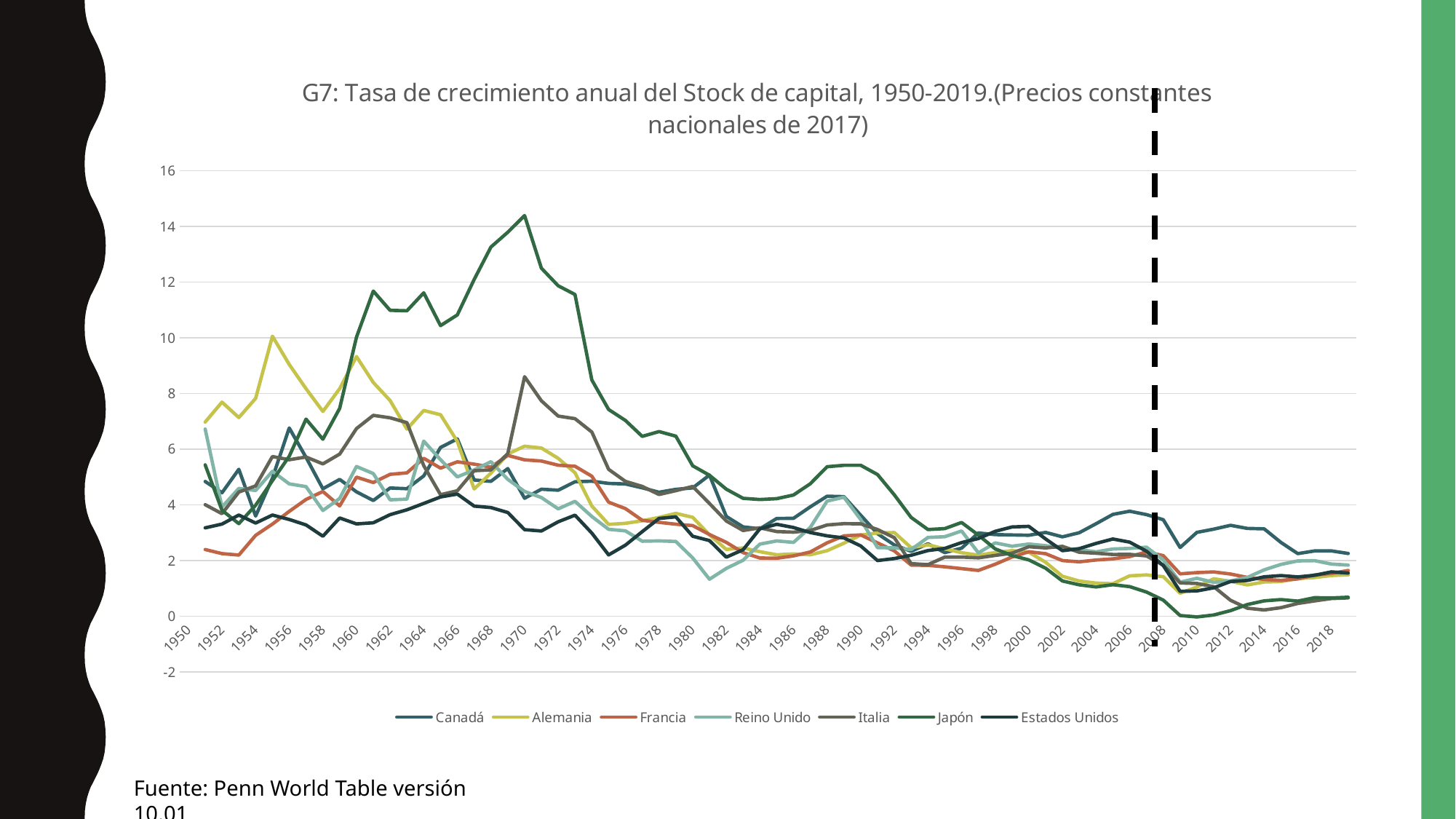
Is the value for Japón in 2010 greater or less than 2? less Does the Alemania series generally rise or fall from 1956 to 1966? fall Is the value for Japón in 1970 greater or less than 12? greater What kind of chart is shown on the slide? line chart In 1970, which series has the higher value, Japón or Italia? Japón Is the value for Alemania in 1956 greater or less than 8? greater Which year does the dashed vertical line on the chart mark? 2008 How many series does the legend list? 7 Which series reaches the highest value anywhere on the chart? Japón What is the highest value shown on the vertical axis? 16 Does the Japón series generally rise or fall from 1970 to 2019? fall